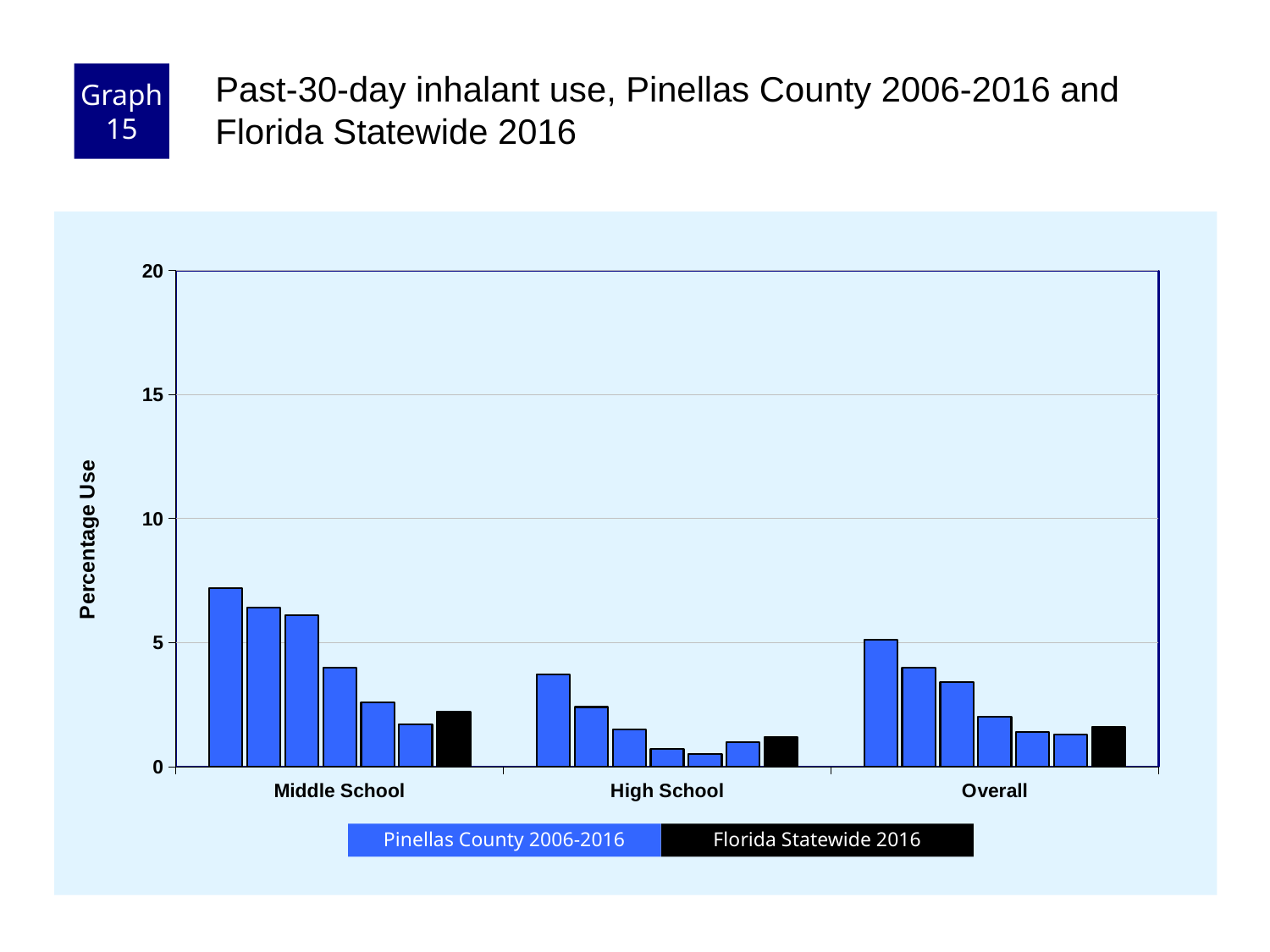
What is the label on the y axis? Percentage Use Is the tallest Pinellas County bar for Middle School greater or less than 5? greater Are any bars in the chart greater than 10? No Which category contains the tallest bar in the chart? Middle School How many school-level categories are shown along the x axis? 3 Do the Pinellas County 2006-2016 bars for Middle School rise or fall from left to right? fall Is the tallest Pinellas County bar for High School greater or less than 5? less Which is larger: the Florida Statewide 2016 bar for Middle School or the Florida Statewide 2016 bar for High School? Middle School What kind of chart is shown on the slide? bar chart What colour represents Florida Statewide 2016 in the legend? black How many series does the legend list? 2